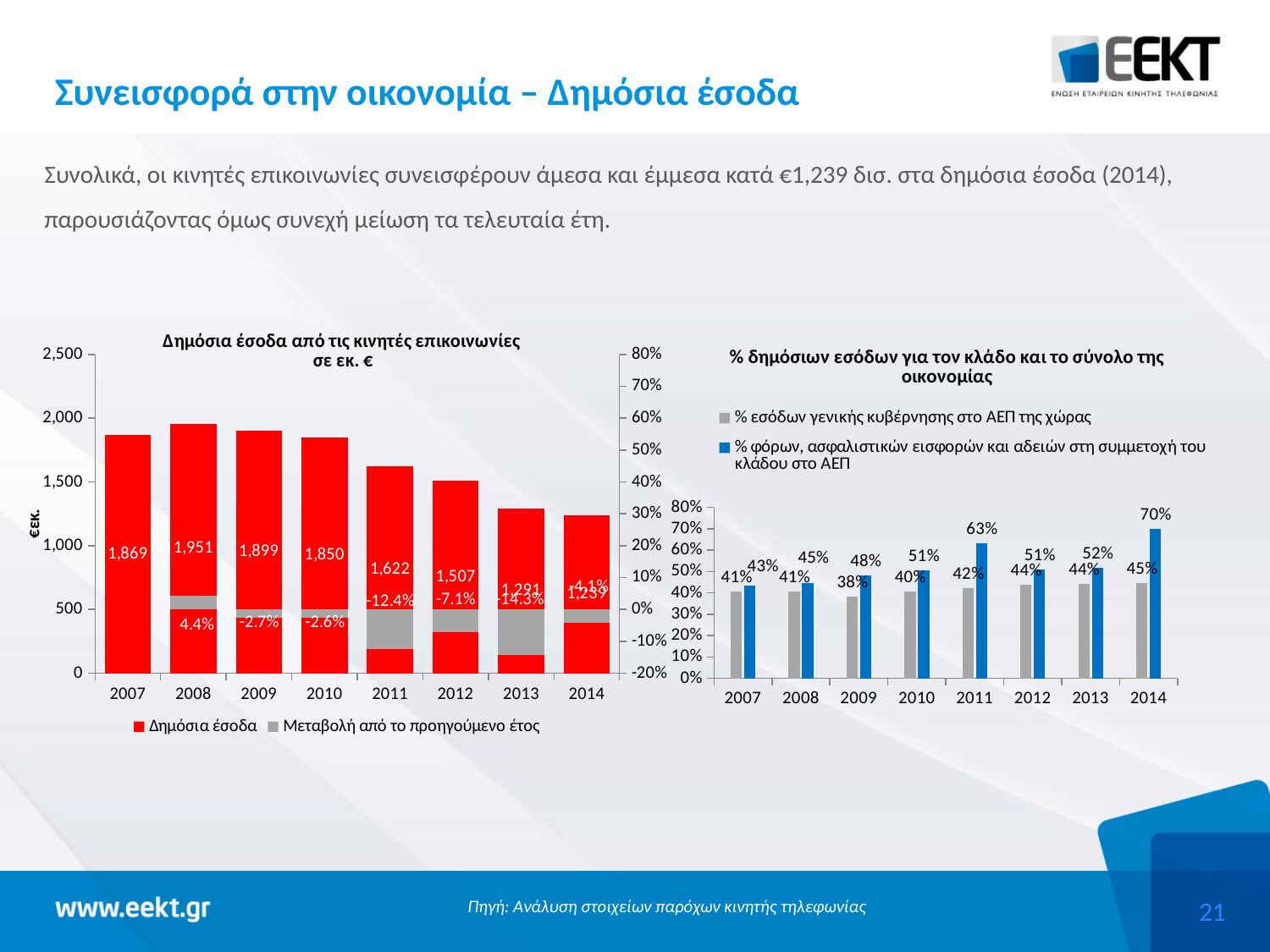
In the left chart 'Δημόσια έσοδα από τις κινητές επικοινωνίες σε εκ. €', what is the value of Δημόσια έσοδα for 2014? 1,239 In the right chart '% δημόσιων εσόδων για τον κλάδο και το σύνολο της οικονομίας', how many series does the legend list? 2 In the left chart 'Δημόσια έσοδα από τις κινητές επικοινωνίες σε εκ. €', which year has the highest Δημόσια έσοδα? 2008 In the left chart 'Δημόσια έσοδα από τις κινητές επικοινωνίες σε εκ. €', do the Δημόσια έσοδα values rise or fall from 2010 to 2014? fall What kind of chart is the right chart '% δημόσιων εσόδων για τον κλάδο και το σύνολο της οικονομίας'? bar chart In the right chart '% δημόσιων εσόδων για τον κλάδο και το σύνολο της οικονομίας', which is larger in 2011: the grey series or the blue series? the blue series In the left chart 'Δημόσια έσοδα από τις κινητές επικοινωνίες σε εκ. €', what is the Μεταβολή από το προηγούμενο έτος for 2013? -14.3% In the left chart 'Δημόσια έσοδα από τις κινητές επικοινωνίες σε εκ. €', what is the difference in Δημόσια έσοδα between 2007 and 2011? 247 In the left chart 'Δημόσια έσοδα από τις κινητές επικοινωνίες σε εκ. €', which year has the lowest Δημόσια έσοδα? 2014 In the left chart 'Δημόσια έσοδα από τις κινητές επικοινωνίες σε εκ. €', how many years are shown on the x axis? 8 In the right chart '% δημόσιων εσόδων για τον κλάδο και το σύνολο της οικονομίας', what is the value of the blue series (% φόρων, ασφαλιστικών εισφορών και αδειών) for 2014? 70% In the right chart '% δημόσιων εσόδων για τον κλάδο και το σύνολο της οικονομίας', what is the value of the grey series (% εσόδων γενικής κυβέρνησης στο ΑΕΠ) for 2009? 38%